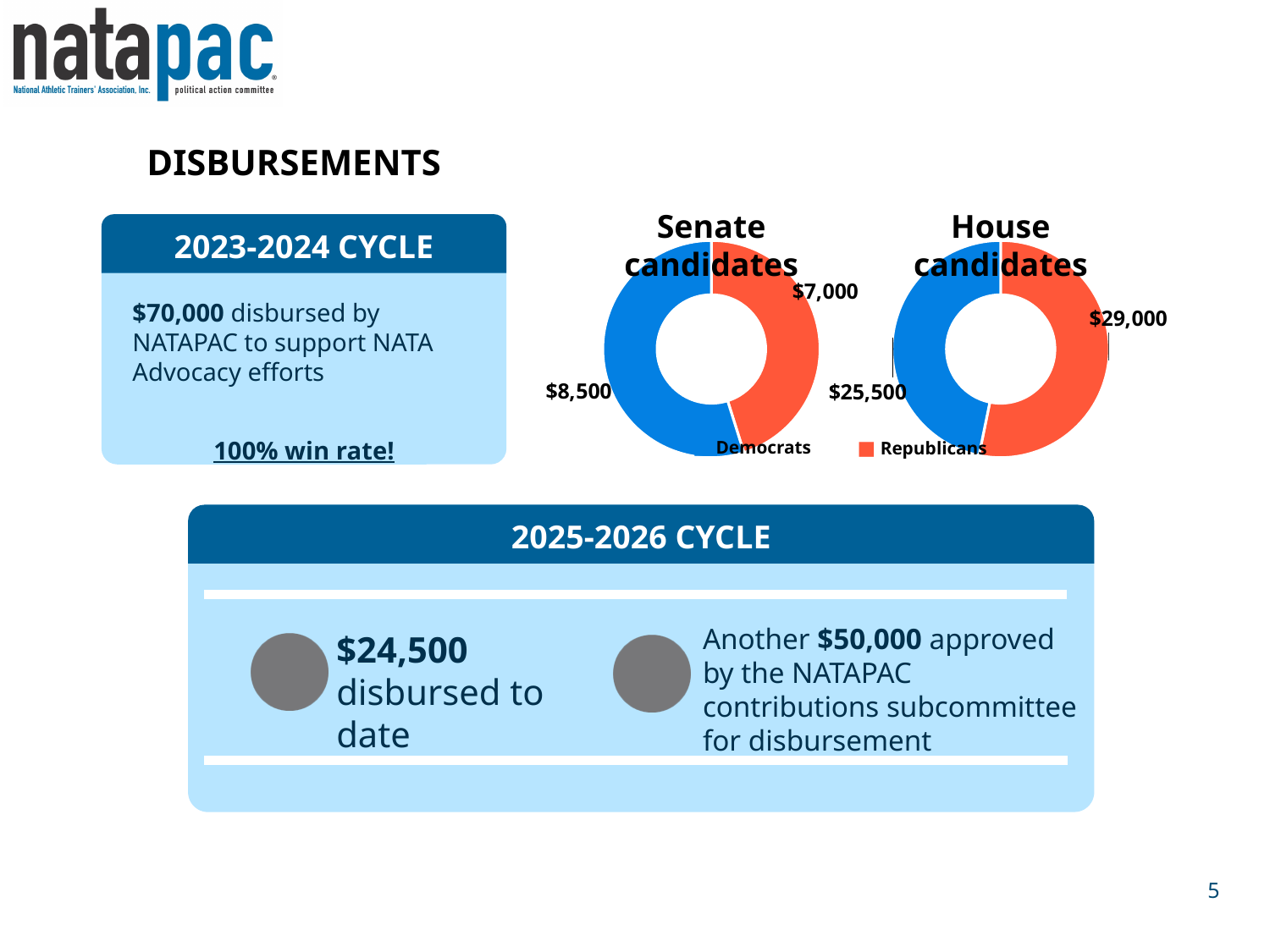
In the House candidates chart, what amount went to Republicans? $29,000 In the House candidates chart, what is the difference between the Republicans and Democrats amounts? $3,500 What type of chart is used for the Senate candidates and House candidates? Pie (donut) chart In the Senate candidates chart, what amount went to Republicans? $7,000 In the Senate candidates chart, which party received the larger amount? Democrats In the House candidates chart, which party received the smaller amount? Democrats In the House candidates chart, what amount went to Democrats? $25,500 How many entries does the legend shared by the two charts list? 2 In the Senate candidates chart, what is the difference between the Democrats and Republicans amounts? $1,500 In the Senate candidates chart, what amount went to Democrats? $8,500 What is the total amount shown in the House candidates chart? $54,500 What is the total amount shown in the Senate candidates chart? $15,500